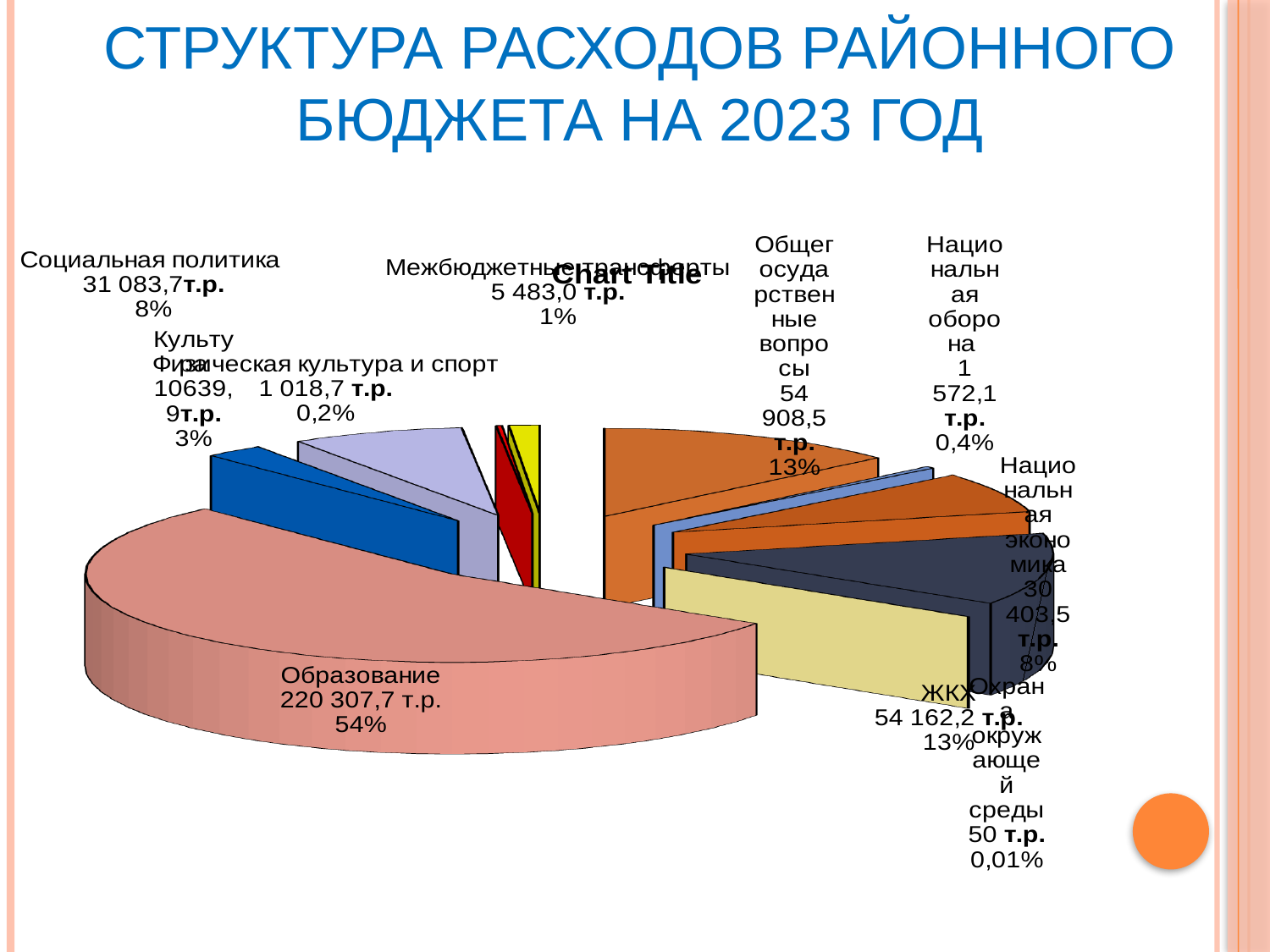
What is the title of the slide? СТРУКТУРА РАСХОДОВ РАЙОННОГО БЮДЖЕТА НА 2023 ГОД What is the value shown for ЖКХ? 54 162,2 т.р. What kind of chart is shown on the slide? pie chart What percentage is shown for Физическая культура и спорт? 0,2% What is the difference between the values for Общегосударственные вопросы and ЖКХ? 746,3 т.р. Which is larger, the value for Социальная политика or the value for Национальная экономика? Социальная политика What is the value shown for Социальная политика? 31 083,7 т.р. Which category has the largest share of the pie? Образование How many categories are shown in the pie chart? 10 Which category has the smallest share of the pie? Охрана окружающей среды What is the value shown for Национальная оборона? 1 572,1 т.р. What share of the pie does Образование account for? 54%